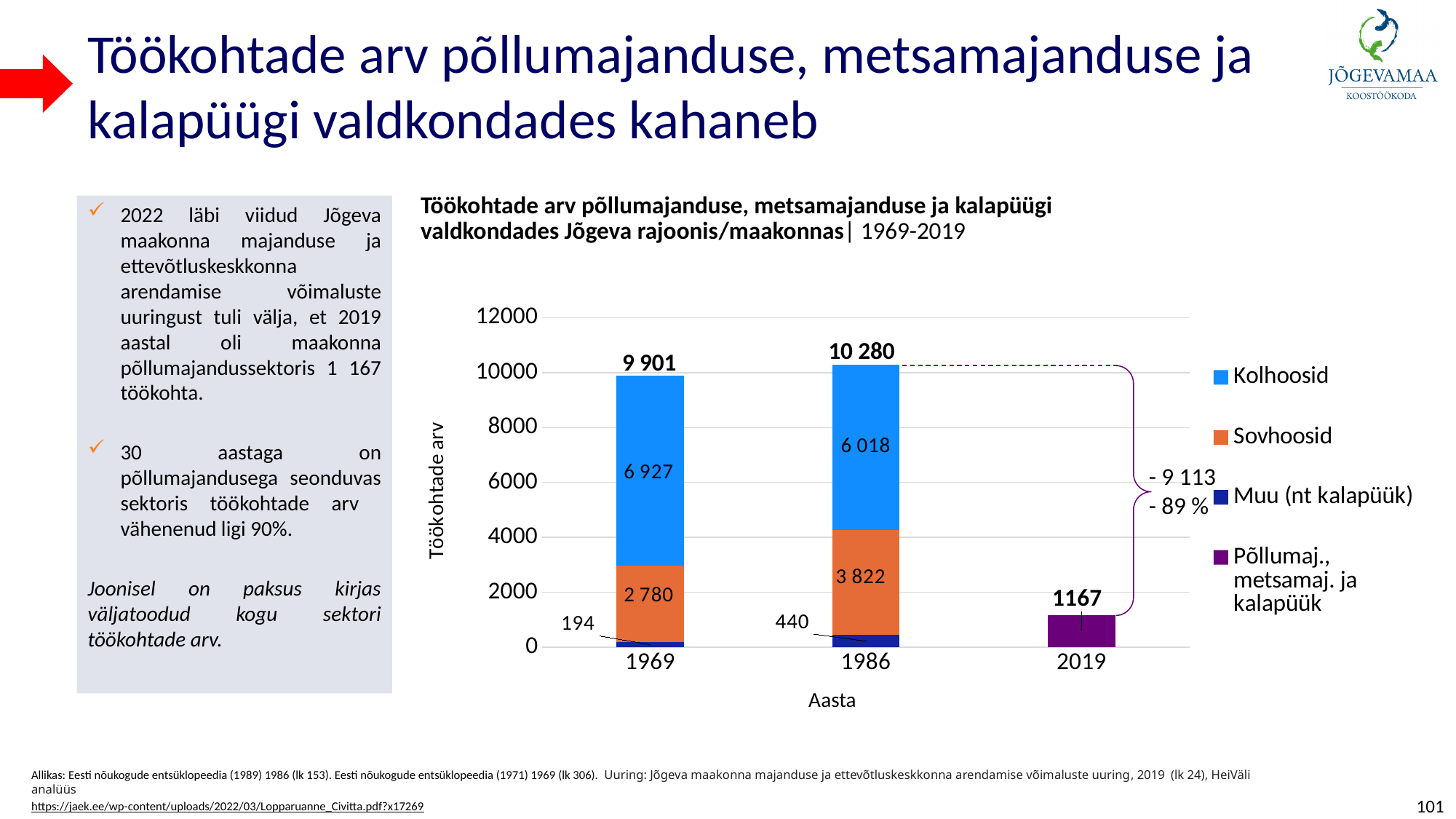
What type of chart is shown on the slide? Stacked bar chart What is the total number of jobs shown for 1986? 10 280 Which year has the lowest total number of jobs? 2019 What is the value for Sovhoosid in 1986? 3 822 What is the value for Muu (nt kalapüük) in 1986? 440 What is the total number of jobs shown for 1969? 9 901 Which is larger: Sovhoosid in 1969 or Sovhoosid in 1986? Sovhoosid in 1986 What is the value for Kolhoosid in 1969? 6 927 What is the difference between the Kolhoosid values in 1969 and 1986? 909 Which year has the highest total number of jobs? 1986 How many series does the legend list? 4 What is the value shown for 2019? 1167